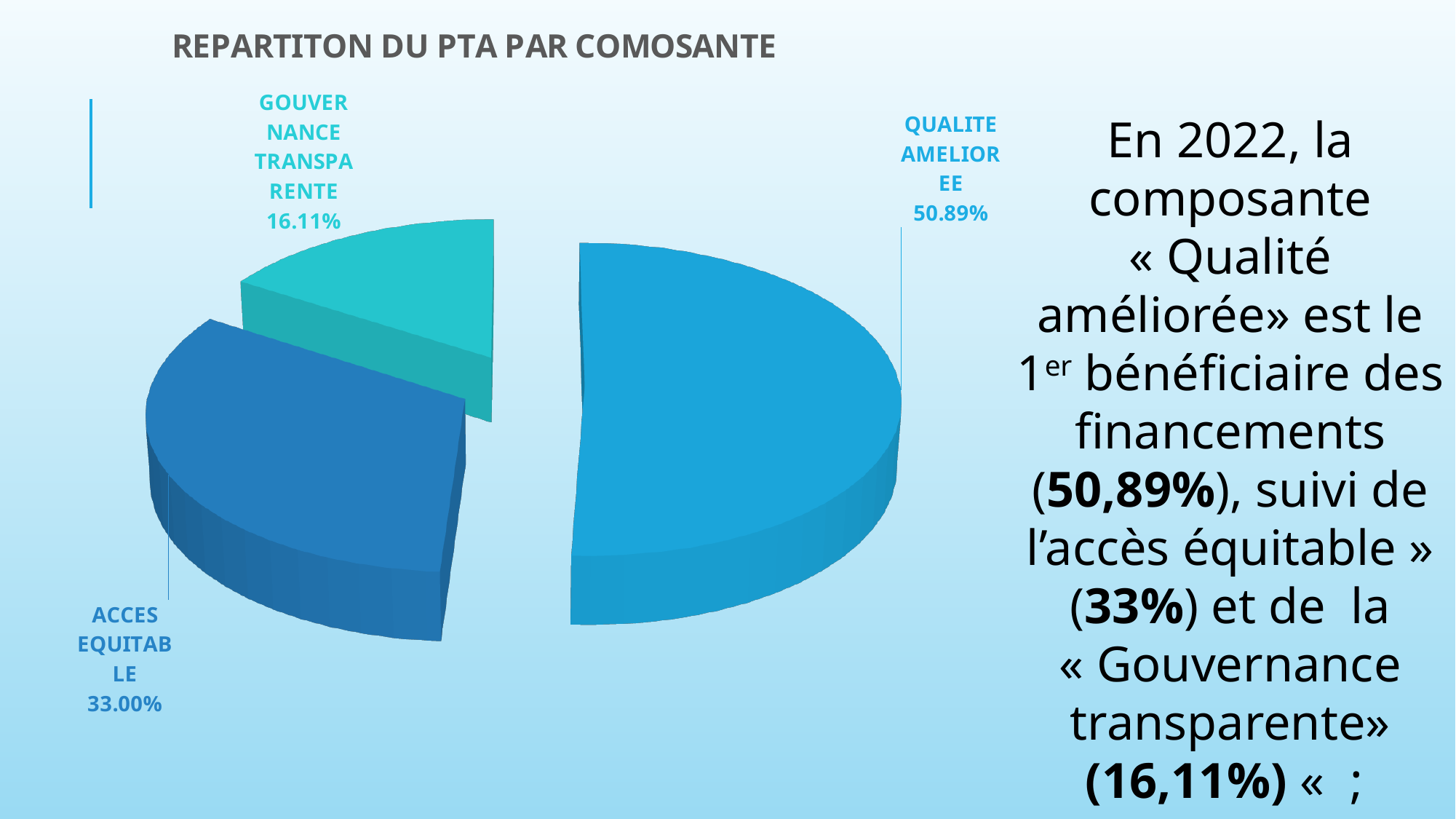
Which component has the largest share of the pie? QUALITE AMELIOREE Is the share for QUALITE AMELIOREE greater or less than 50%? greater Which is larger, the share for ACCES EQUITABLE or the share for GOUVERNANCE TRANSPARENTE? ACCES EQUITABLE What share of the pie does ACCES EQUITABLE represent? 33.00% How many slices does the pie chart have? 3 What kind of chart is shown on the slide? Pie chart What share of the pie does GOUVERNANCE TRANSPARENTE represent? 16.11% What is the title of the chart? REPARTITON DU PTA PAR COMOSANTE What is the difference in percentage points between ACCES EQUITABLE and GOUVERNANCE TRANSPARENTE? 16.89 What share of the pie does QUALITE AMELIOREE represent? 50.89% What is the difference in percentage points between QUALITE AMELIOREE and ACCES EQUITABLE? 17.89 Which component has the smallest share of the pie? GOUVERNANCE TRANSPARENTE